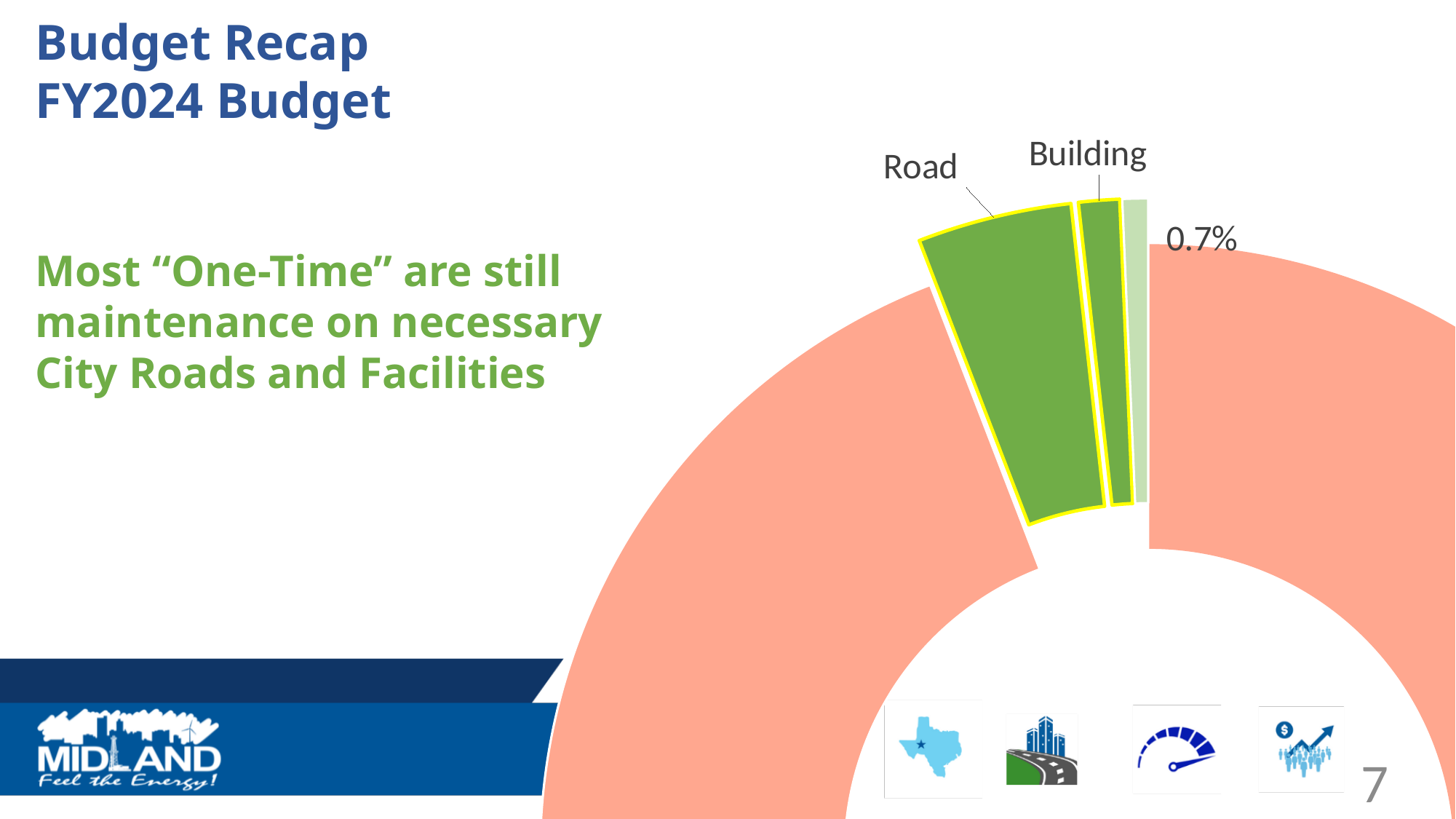
What colour is the largest slice of the chart? salmon (light orange) What percentage value is printed on the chart? 0.7% Which of the two named slices, Road or Building, is the smaller one? Building How many slices on the chart are labeled with a category name? 2 What kind of chart is shown on the slide? doughnut chart Which slice is larger, Road or Building? Road What colour are the Road and Building slices? green